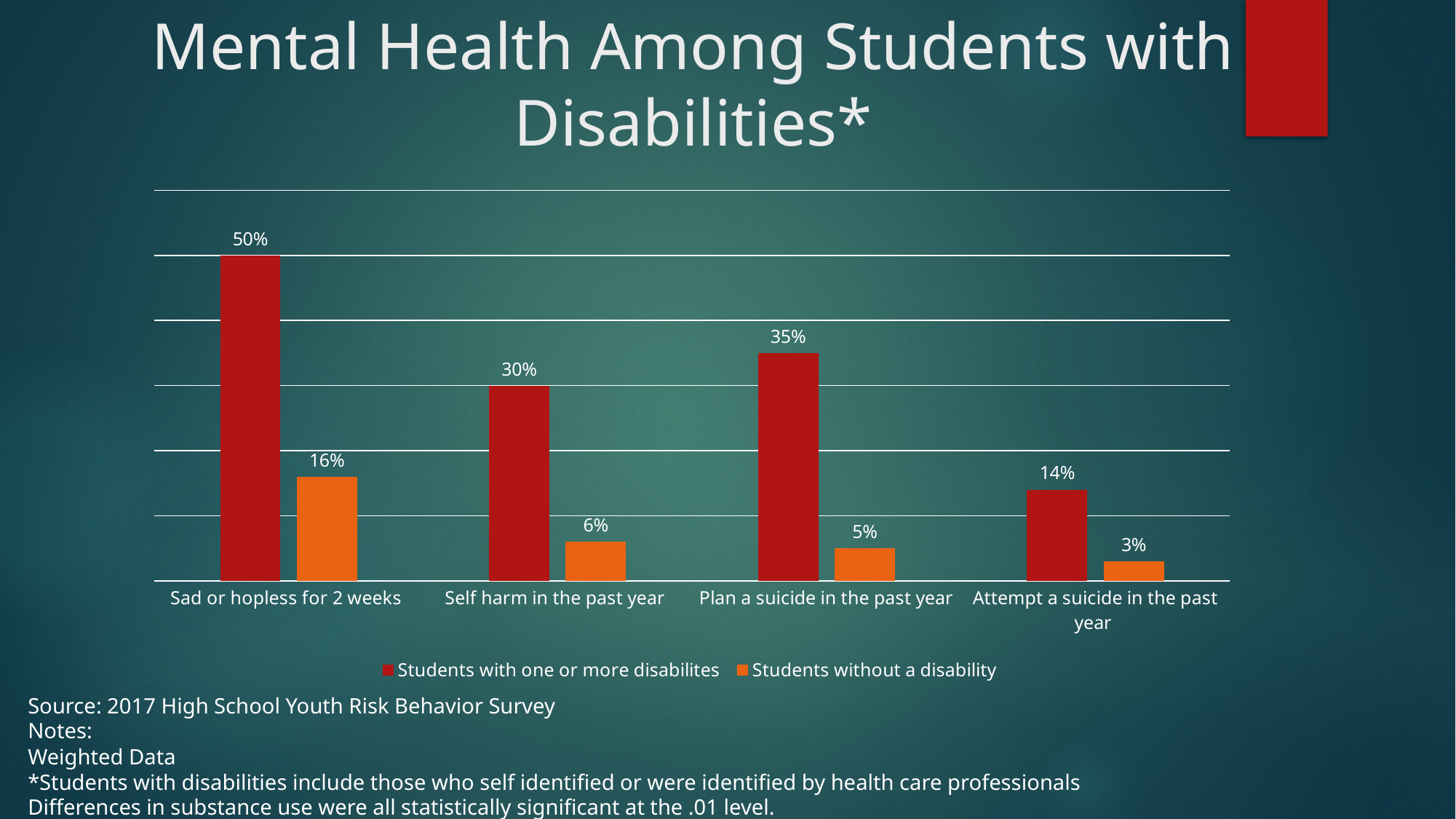
What kind of chart is shown on the slide? Bar chart What is the value for students with one or more disabilities for 'Plan a suicide in the past year'? 35% What is the difference between students with one or more disabilities and students without a disability for 'Sad or hopless for 2 weeks'? 34% Which category has the lowest value for students without a disability? Attempt a suicide in the past year For 'Self harm in the past year', which group has the larger value: students with one or more disabilities or students without a disability? Students with one or more disabilites How many categories are shown on the x axis? 4 What percentage of students without a disability reported self harm in the past year? 6% What is the value for students without a disability for 'Attempt a suicide in the past year'? 3% What is the difference between students with one or more disabilities and students without a disability for 'Plan a suicide in the past year'? 30% How many series does the legend list? 2 What percentage of students with one or more disabilities reported being sad or hopeless for 2 weeks? 50% Which category has the highest value for students with one or more disabilities? Sad or hopless for 2 weeks